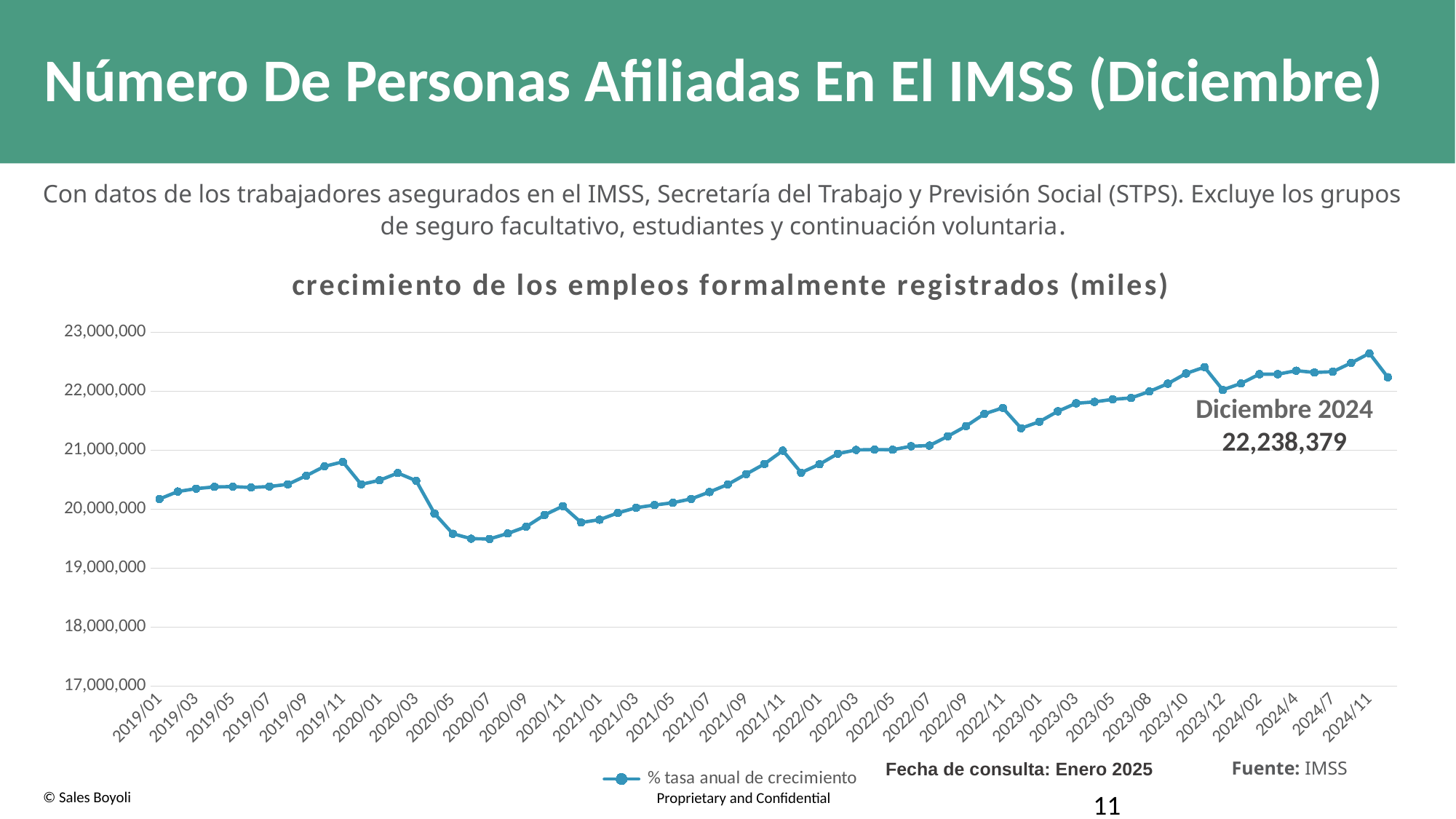
Is the value for 2019/01 greater or less than 21,000,000? less Which is larger, the value for 2019/11 or the value for 2020/07? 2019/11 What value is printed on the chart for Diciembre 2024? 22,238,379 Is the value for 2020/07 greater or less than 20,000,000? less What is the legend entry for the plotted series? % tasa anual de crecimiento How many series does the legend list? 1 Overall, do the values rise or fall from 2019/01 to 2024/11? rise Is the value for 2024/11 greater or less than 22,000,000? greater Which month has the highest value on the chart? 2024/11 In which year does the line reach its lowest point? 2020 What kind of chart is shown on the slide? line chart